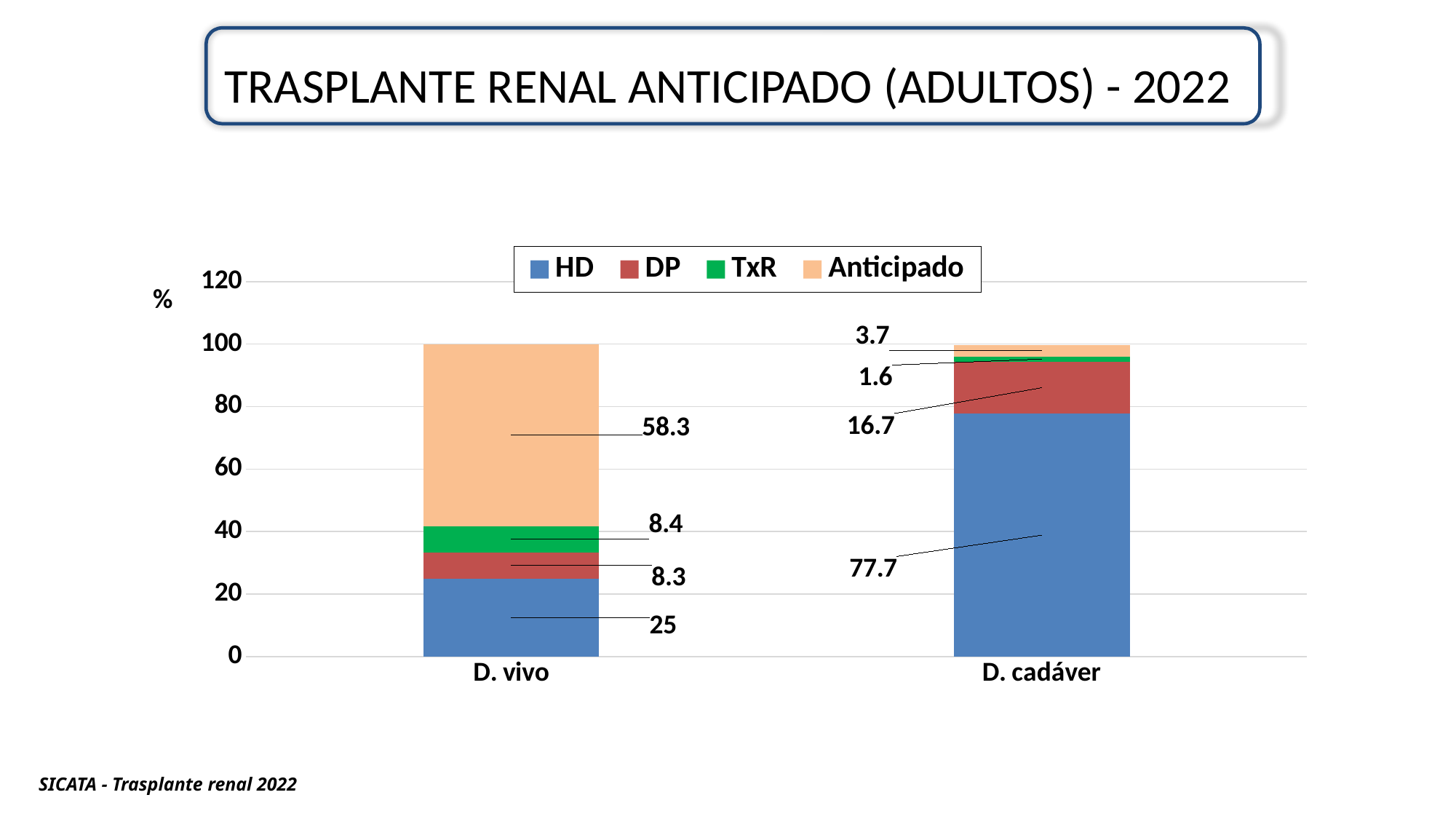
How many series does the legend list? 4 Which category has the higher Anticipado value? D. vivo What is the HD value for D. vivo? 25 What is the total of the stacked bar for D. cadáver? 99.7 What is the Anticipado value for D. cadáver? 3.7 How many categories are shown on the x axis? 2 What is the difference between the Anticipado values for D. vivo and D. cadáver? 54.6 What is the DP value for D. cadáver? 16.7 What is the TxR value for D. vivo? 8.4 Which category has the higher HD value, D. vivo or D. cadáver? D. cadáver What is the difference between the HD values for D. cadáver and D. vivo? 52.7 What type of chart is shown on the slide? Stacked bar chart